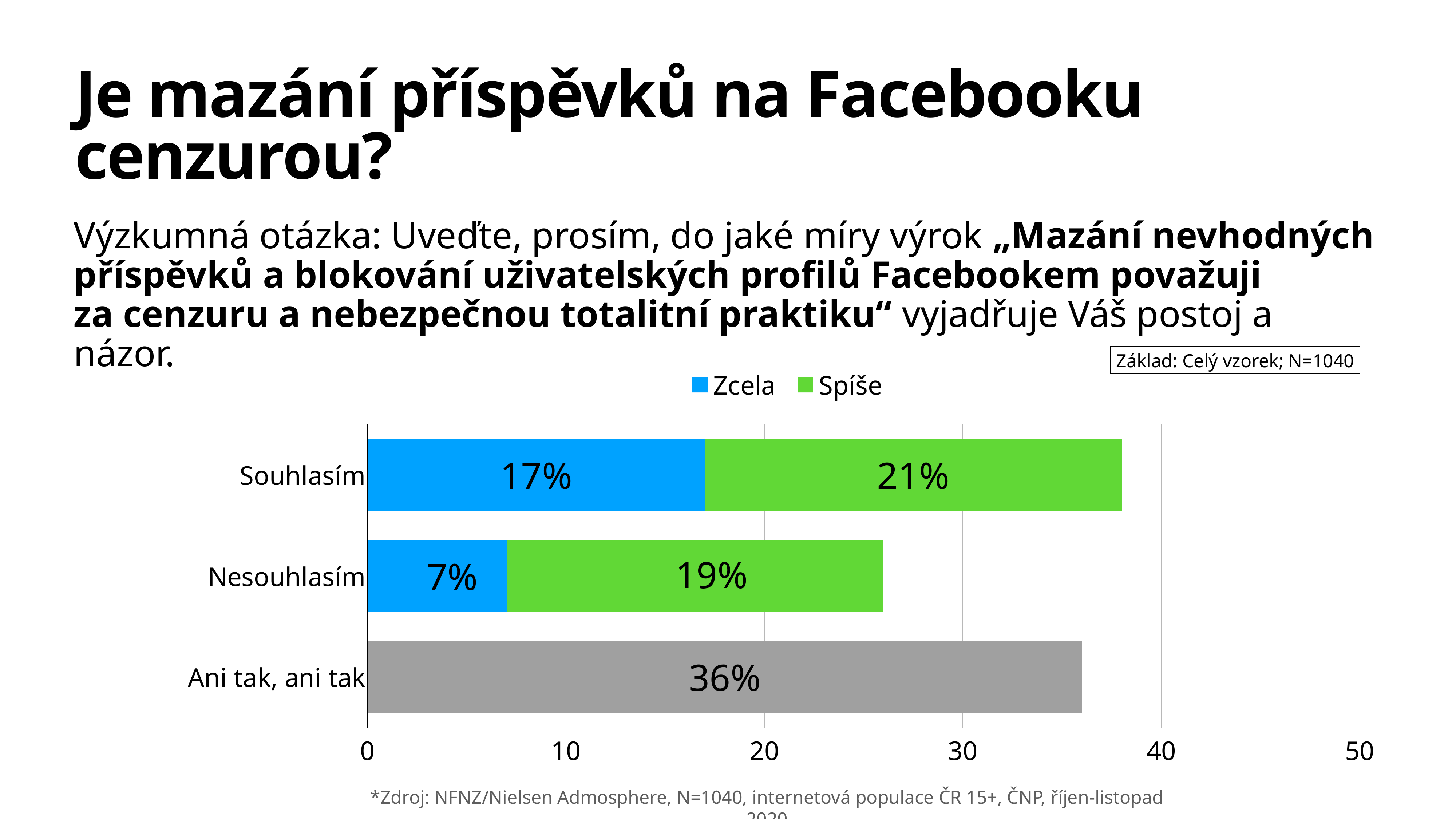
What is the Spíše value for Nesouhlasím? 19% What is the Zcela value for Souhlasím? 17% What is the difference between the Zcela values for Souhlasím and Nesouhlasím? 10% Which category has the lowest Zcela value? Nesouhlasím What kind of chart is shown on the slide? Stacked bar chart How many categories are shown on the vertical axis? 3 What value is shown for Ani tak, ani tak? 36% What is the Spíše value for Souhlasím? 21% How many series does the legend list? 2 What is the total of the stacked bar for Souhlasím? 38% What is the total of the stacked bar for Nesouhlasím? 26% Which is larger: the Spíše value for Souhlasím or the Spíše value for Nesouhlasím? Souhlasím